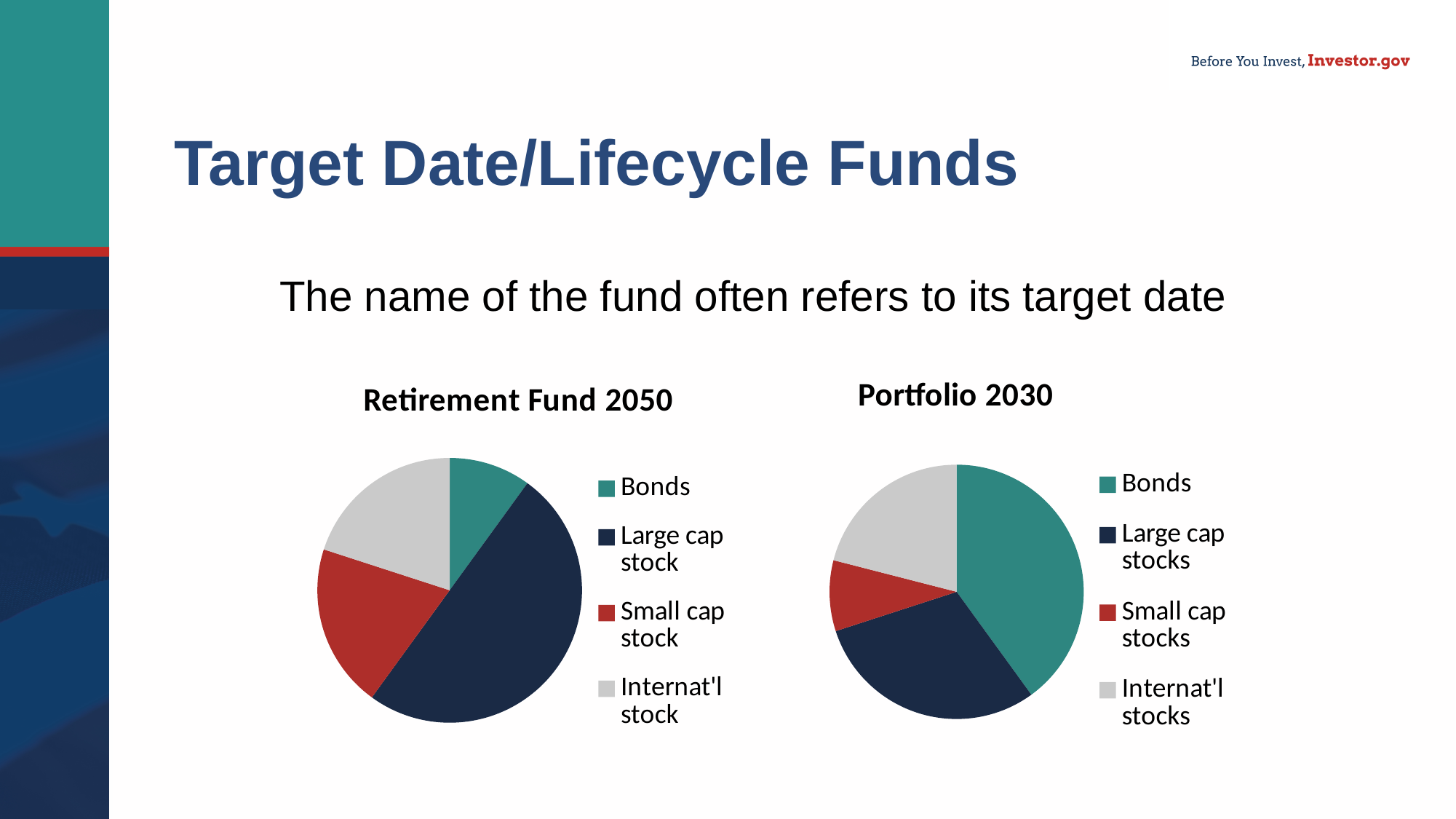
What kind of chart is the Portfolio 2030 chart? Pie chart In the Portfolio 2030 chart, what colour is the Bonds slice? Teal In the Portfolio 2030 chart, which category has the largest slice? Bonds How many slices does the Portfolio 2030 pie chart have? 4 What kind of chart is the Retirement Fund 2050 chart? Pie chart What is the title of the pie chart on the left of the slide? Retirement Fund 2050 In the Portfolio 2030 chart, which category has the smallest slice? Small cap stocks In the Retirement Fund 2050 chart, which category has the smallest slice? Bonds In the Retirement Fund 2050 chart, which category has the largest slice? Large cap stock In the Retirement Fund 2050 chart, which slice is larger: Bonds or Large cap stock? Large cap stock How many slices does the Retirement Fund 2050 pie chart have? 4 In the Portfolio 2030 chart, which slice is larger: Bonds or Small cap stocks? Bonds